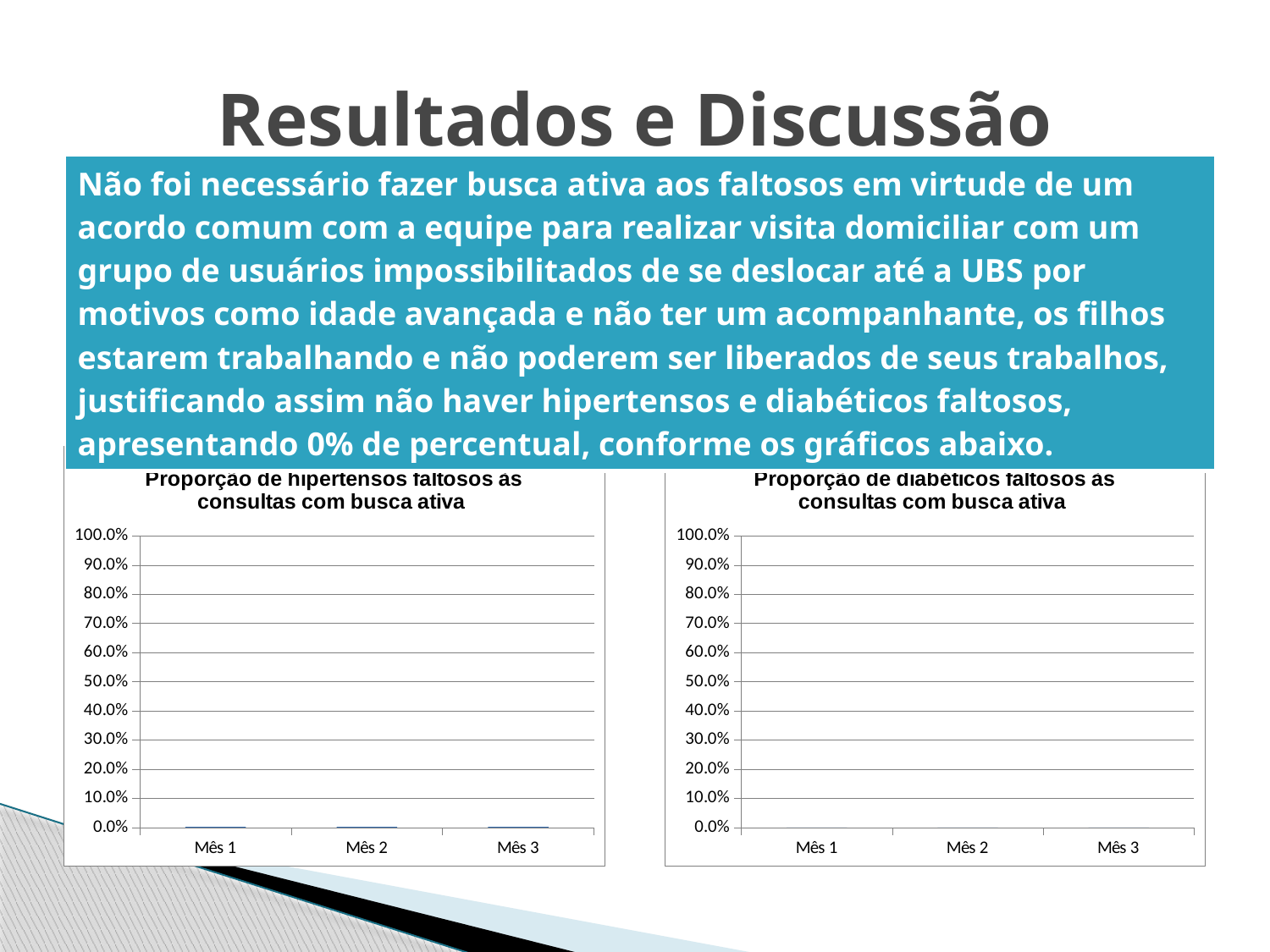
How many categories are shown on the x axis of the right chart, 'Proporção de diabéticos faltosos às consultas com busca ativa'? 3 What kind of chart is the left chart, 'Proporção de hipertensos faltosos às consultas com busca ativa'? bar chart In the right chart, 'Proporção de diabéticos faltosos às consultas com busca ativa', is the value for Mês 1 greater or less than 10.0%? less In the left chart, 'Proporção de hipertensos faltosos às consultas com busca ativa', is the value for Mês 3 greater or less than 50.0%? less What is the title of the right chart on the slide? Proporção de diabéticos faltosos às consultas com busca ativa What is the highest tick label on the y axis of the left chart, 'Proporção de hipertensos faltosos às consultas com busca ativa'? 100.0% In the right chart, 'Proporção de diabéticos faltosos às consultas com busca ativa', what is the difference between the values for Mês 1 and Mês 3? 0.0% How many categories are shown on the x axis of the left chart, 'Proporção de hipertensos faltosos às consultas com busca ativa'? 3 In the left chart, 'Proporção de hipertensos faltosos às consultas com busca ativa', do the values rise, fall, or stay flat from Mês 1 to Mês 3? stay flat In the right chart, 'Proporção de diabéticos faltosos às consultas com busca ativa', what is the value for Mês 2? 0.0% In the left chart, 'Proporção de hipertensos faltosos às consultas com busca ativa', what is the value for Mês 1? 0.0%